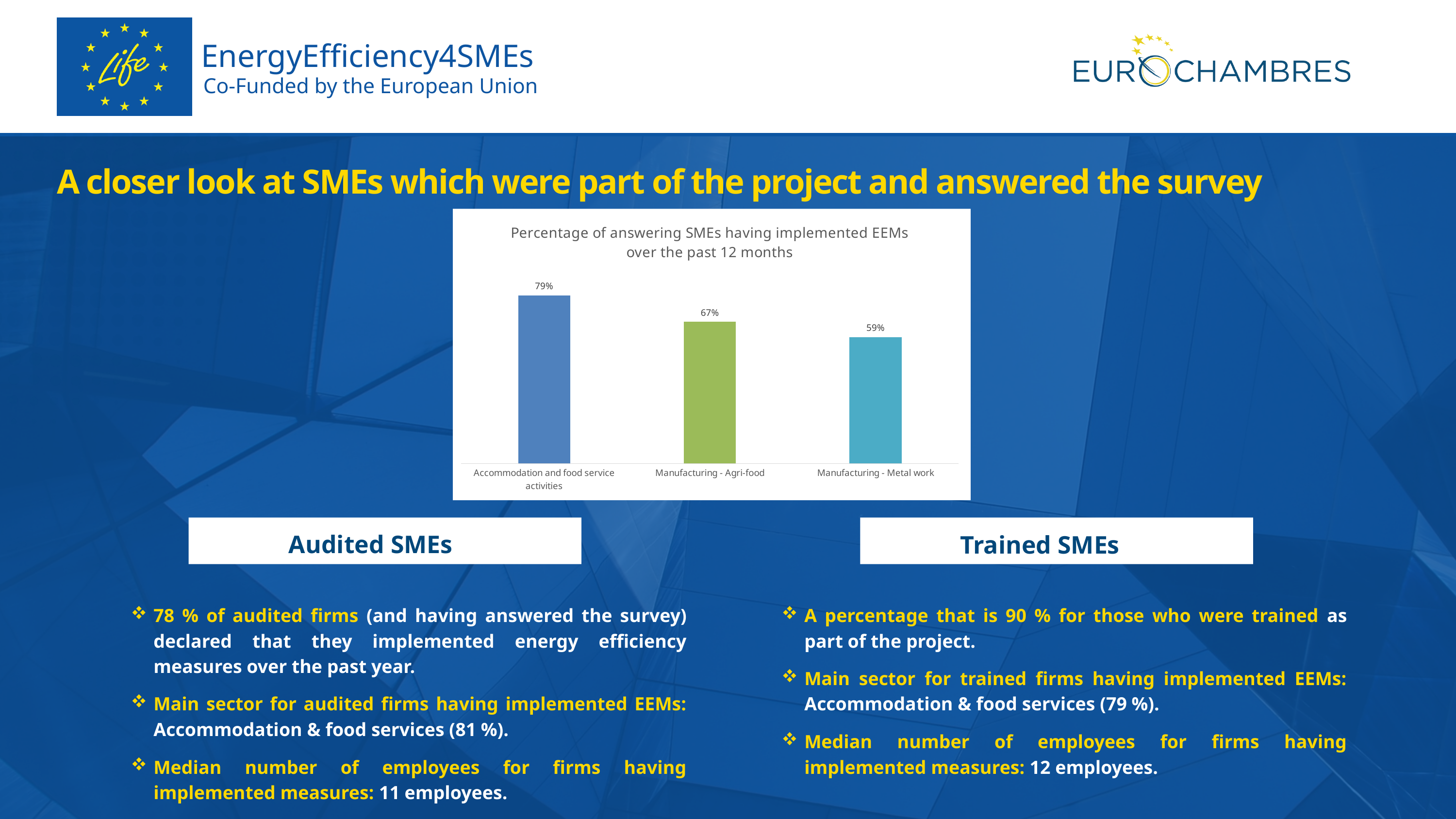
What is the difference between the values for Manufacturing - Agri-food and Manufacturing - Metal work? 8% What is the value for Manufacturing - Metal work? 59% Do the values rise or fall from left to right across the categories? Fall What is the value for Manufacturing - Agri-food? 67% How many categories are shown in the chart? 3 What kind of chart is shown on the slide? Bar chart Which is larger, the value for Manufacturing - Agri-food or Manufacturing - Metal work? Manufacturing - Agri-food Which category has the lowest percentage? Manufacturing - Metal work What is the difference between the values for Accommodation and food service activities and Manufacturing - Metal work? 20% What is the value for Accommodation and food service activities? 79% Which category has the highest percentage? Accommodation and food service activities What is the title of the chart? Percentage of answering SMEs having implemented EEMs over the past 12 months